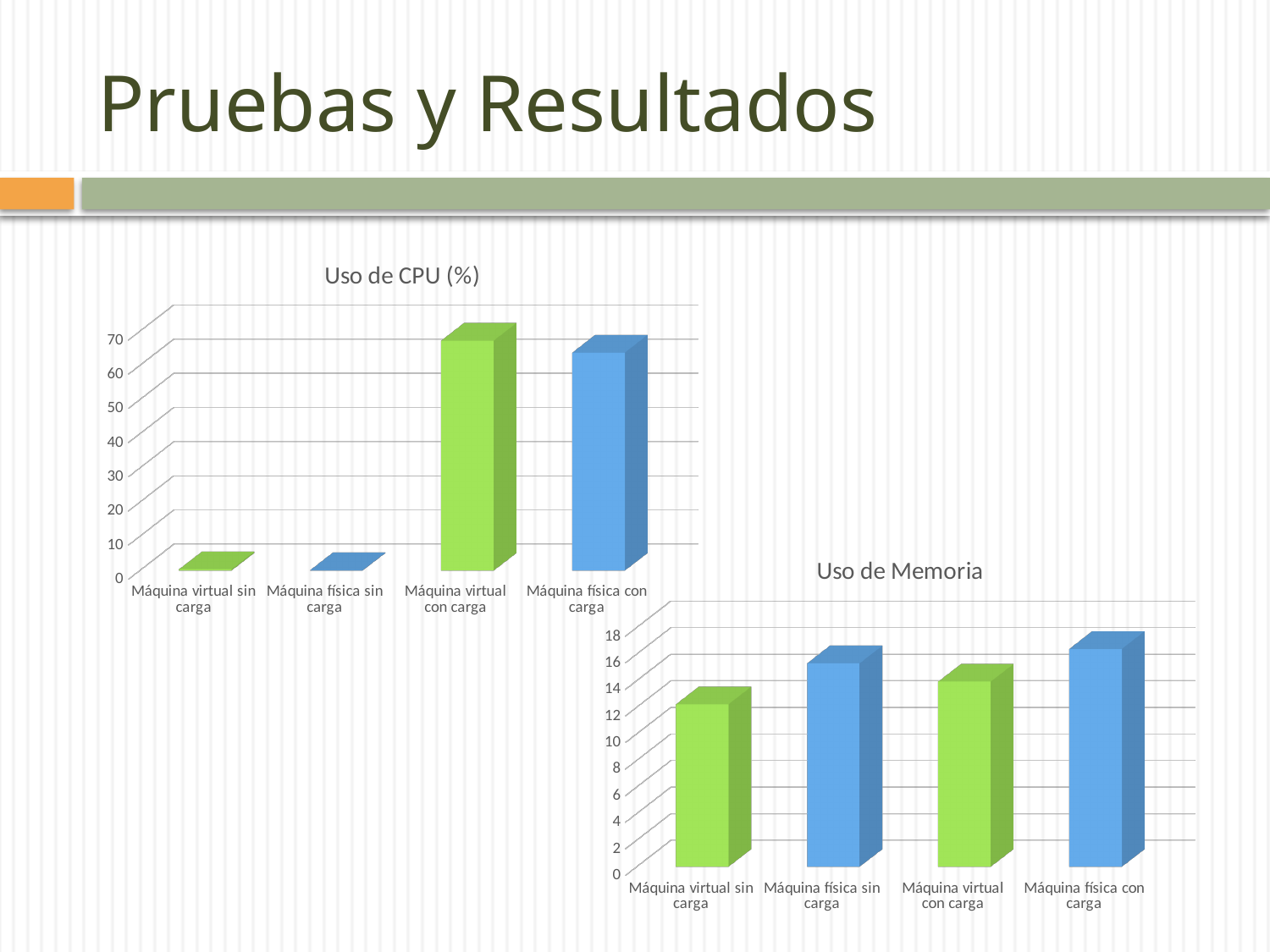
In the 'Uso de Memoria' chart, is the value for Máquina física con carga greater or less than 14? greater What kind of chart is the 'Uso de CPU (%)' chart? bar chart In the 'Uso de CPU (%)' chart, is the value for Máquina virtual con carga greater or less than 60? greater How many categories are shown in the 'Uso de Memoria' chart? 4 In the 'Uso de CPU (%)' chart, which category has the highest value? Máquina virtual con carga In the 'Uso de Memoria' chart, is the value for Máquina virtual sin carga greater or less than 14? less What is the title of the chart on the lower right of the slide? Uso de Memoria In the 'Uso de Memoria' chart, which category has the lowest value? Máquina virtual sin carga In the 'Uso de Memoria' chart, which category has the highest value? Máquina física con carga In the 'Uso de CPU (%)' chart, which is larger: Máquina virtual con carga or Máquina física sin carga? Máquina virtual con carga In the 'Uso de Memoria' chart, which is larger: Máquina física sin carga or Máquina virtual con carga? Máquina física sin carga